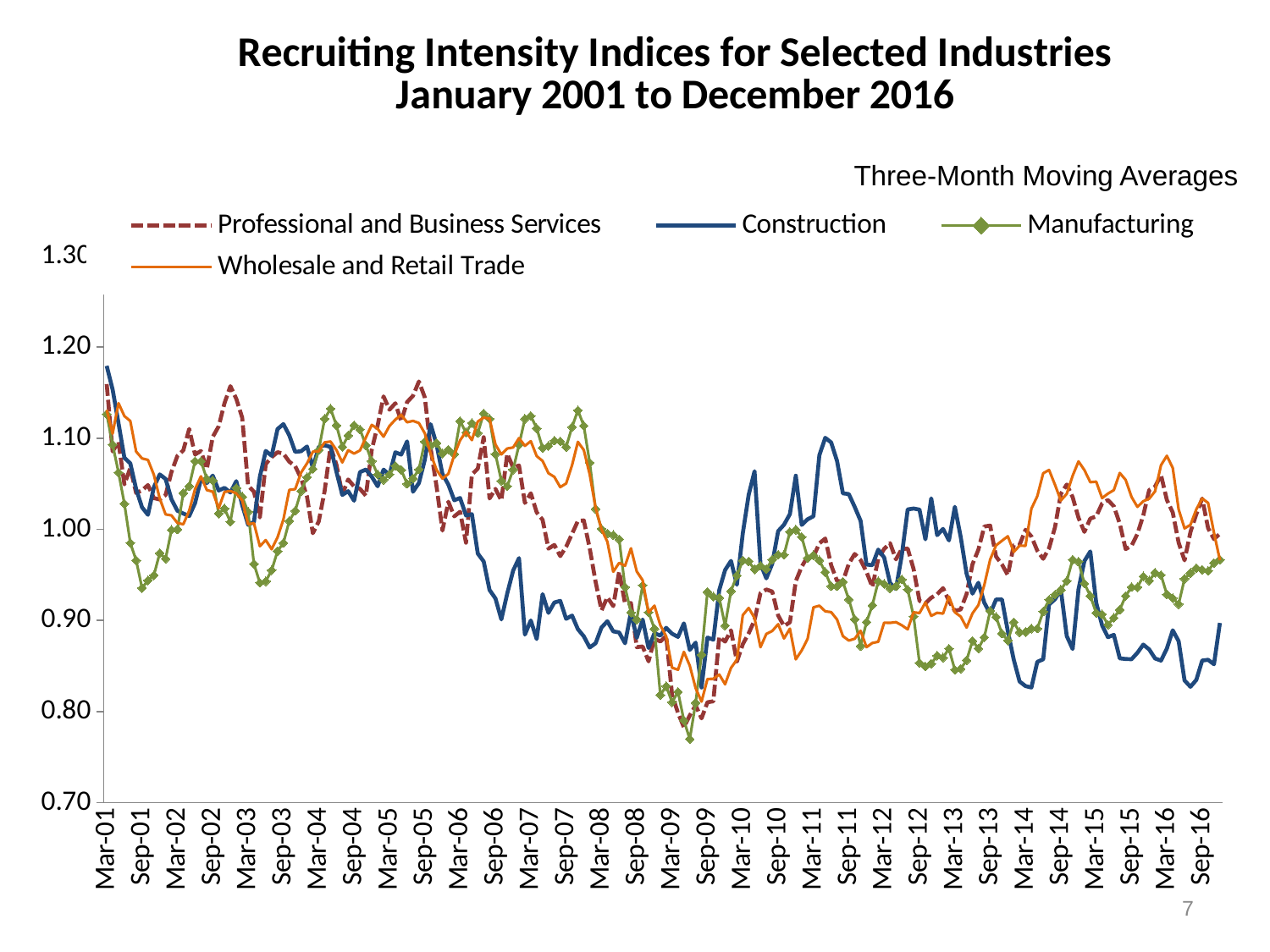
At Mar-11, which is higher: Construction or Manufacturing? Construction Which series has the lowest value at Sep-09? Professional and Business Services What kind of chart is shown on the slide? line chart What is the title of the chart? Recruiting Intensity Indices for Selected Industries January 2001 to December 2016 Which series is drawn with a dashed line? Professional and Business Services How many series does the legend list? 4 Is the value for Wholesale and Retail Trade at Mar-16 greater or less than 1.00? greater At Sep-16, which is higher: Wholesale and Retail Trade or Construction? Wholesale and Retail Trade Does the Construction series rise or fall from Mar-06 to Sep-09? fall Is the value for Manufacturing at Sep-09 greater or less than 0.80? greater Is the value for Construction at Mar-01 greater or less than 1.10? greater